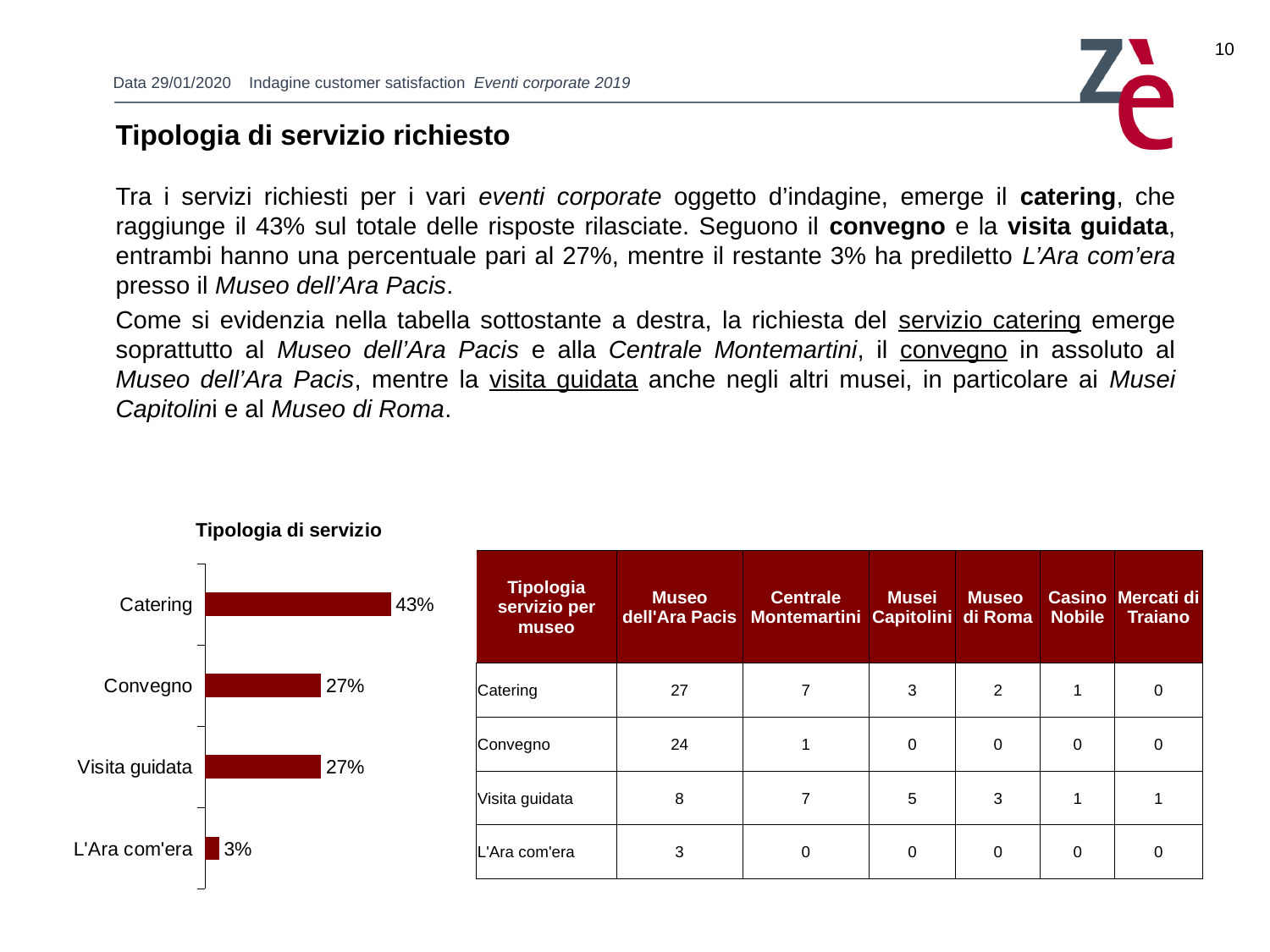
Which category has the lowest value in the Tipologia di servizio chart? L'Ara com'era What kind of chart is the Tipologia di servizio chart? Bar chart What is the value for Convegno in the Tipologia di servizio chart? 27% What is the title of the chart on the slide? Tipologia di servizio What colour are the bars in the Tipologia di servizio chart? Dark red What is the value for Catering in the Tipologia di servizio chart? 43% Which is larger in the Tipologia di servizio chart, Catering or Visita guidata? Catering What is the value for L'Ara com'era in the Tipologia di servizio chart? 3% How many categories are shown in the Tipologia di servizio chart? 4 What is the difference between the values for Visita guidata and L'Ara com'era in the Tipologia di servizio chart? 24% What is the difference between the values for Catering and Convegno in the Tipologia di servizio chart? 16% Which category has the highest value in the Tipologia di servizio chart? Catering